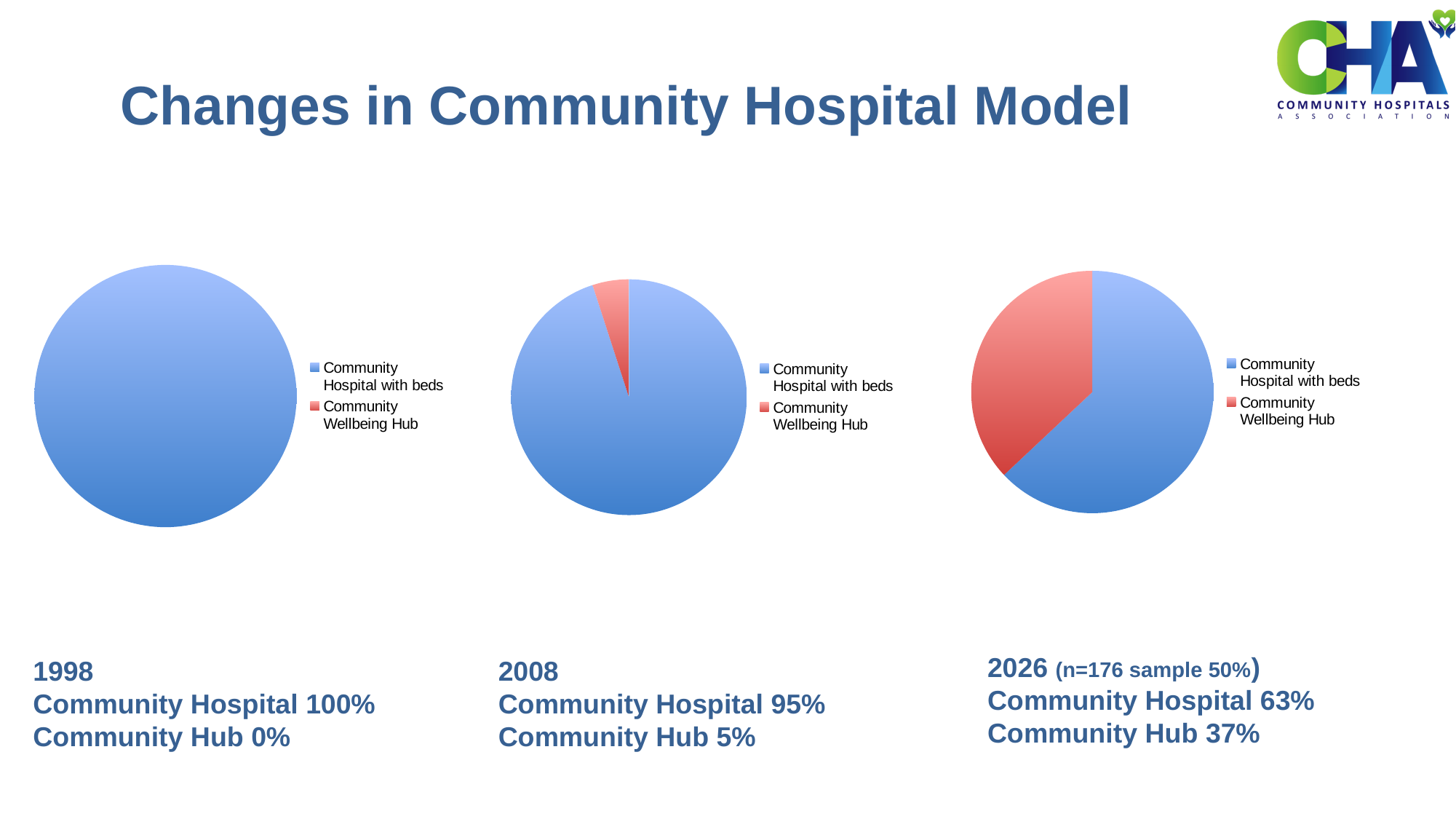
In the 2008 pie chart (middle), which slice is larger, Community Hospital with beds or Community Wellbeing Hub? Community Hospital with beds In the 1998 pie chart (left), what share is Community Hospital? 100% In the 2026 pie chart (right), what share is Community Hub? 37% In the 2026 pie chart (right), what is the difference between the Community Hospital share and the Community Hub share? 26% What colour represents Community Wellbeing Hub in the pie charts? Red Across the three pie charts from 1998 to 2026, does the Community Hub share rise or fall? Rise How many entries does the legend of the 2026 pie chart (right) list? 2 Which of the three pie charts has the largest Community Wellbeing Hub slice? 2026 In the 2008 pie chart (middle), what share is Community Hub? 5% In the 2026 pie chart (right), what share is Community Hospital? 63% How many pie charts are on the slide? 3 What kind of charts are shown on the slide? Pie charts